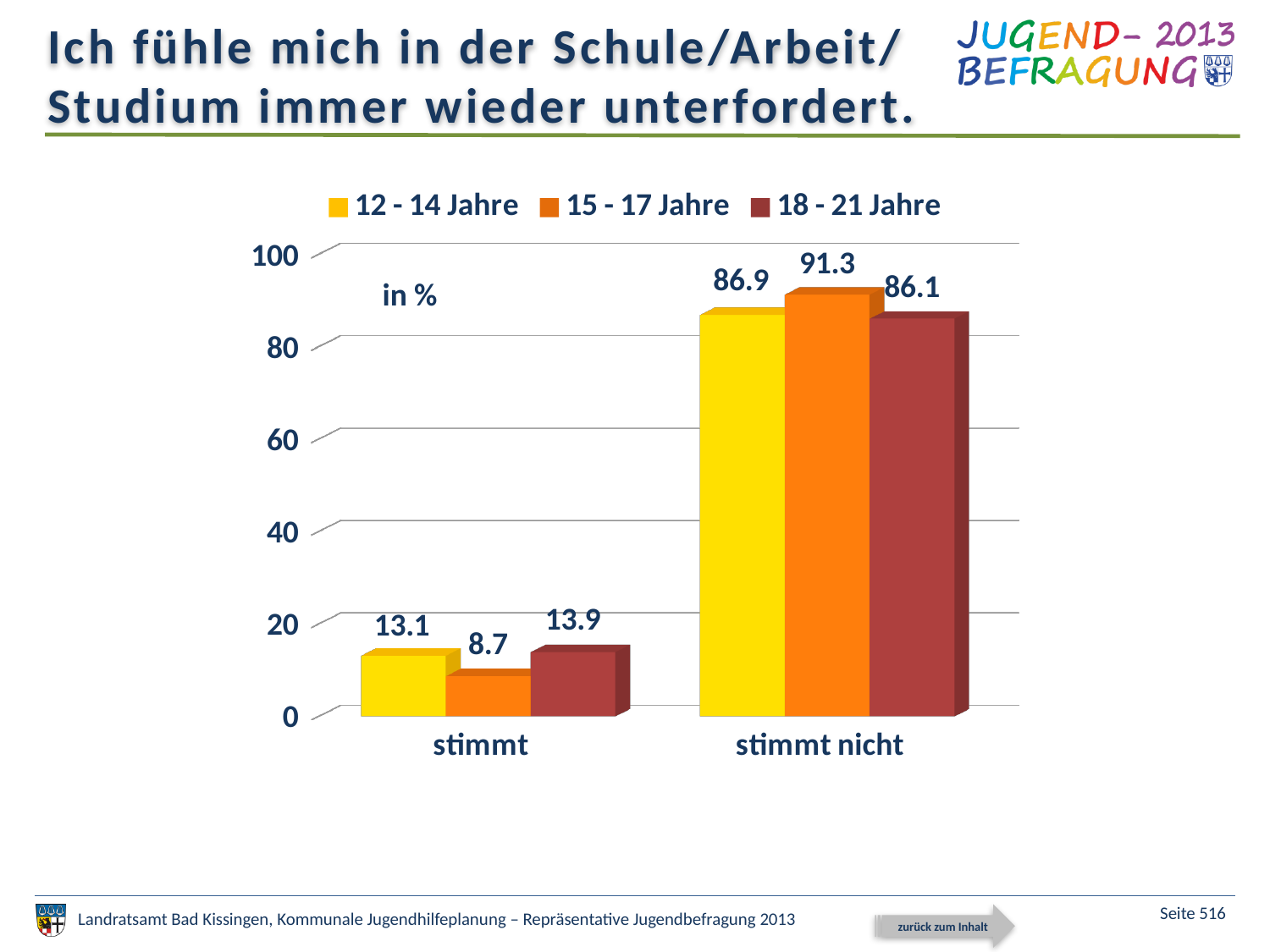
What is the value for the 15 - 17 Jahre series in the "stimmt nicht" category? 91.3 How many categories are shown on the x axis? 2 Which is larger in the "stimmt" category: the value for 12 - 14 Jahre or the value for 18 - 21 Jahre? 18 - 21 Jahre Which colour represents the 15 - 17 Jahre series in the legend? orange What kind of chart is shown on the slide? bar chart What is the value for the 18 - 21 Jahre series in the "stimmt" category? 13.9 Which age group has the lowest value in the "stimmt" category? 15 - 17 Jahre Which age group has the highest value in the "stimmt nicht" category? 15 - 17 Jahre How many series does the legend list? 3 Is the value for 18 - 21 Jahre in the "stimmt nicht" category greater or less than 80? greater What is the value for the 12 - 14 Jahre series in the "stimmt" category? 13.1 What is the difference between the 15 - 17 Jahre value and the 12 - 14 Jahre value in the "stimmt nicht" category? 4.4